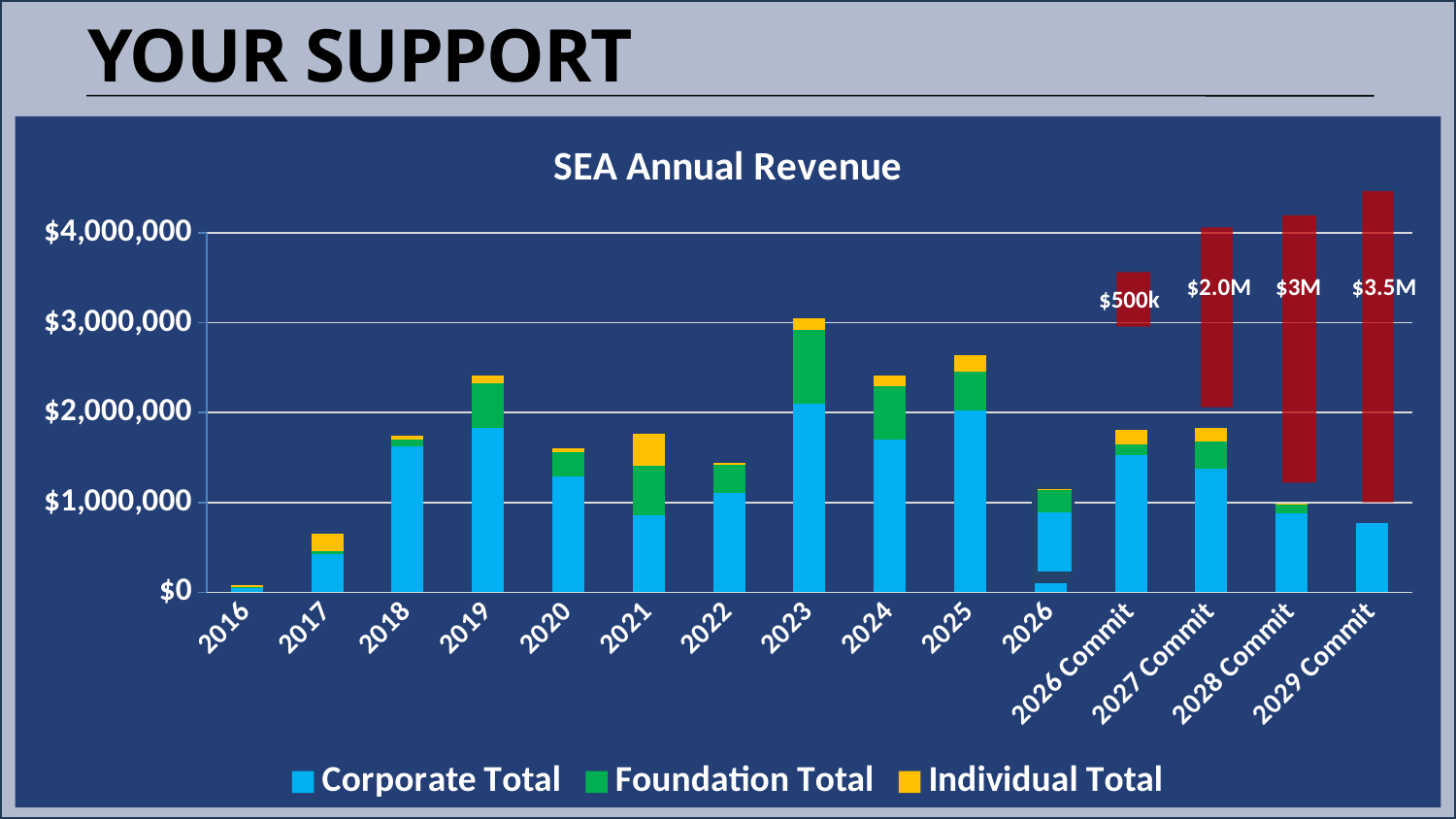
Which has the larger total stacked bar, 2024 or 2025? 2025 Is the total value for 2022 greater or less than $1,000,000? greater What type of chart is shown on the slide? bar chart Do the total values rise or fall from 2016 to 2019? rise What label is printed on the red bar above 2029 Commit? $3.5M Is the total value for 2019 greater or less than $2,000,000? greater Is the total value for 2017 greater or less than $1,000,000? less Which year has the highest total stacked bar? 2023 How many series does the legend list? 3 Which category has the lowest total stacked bar? 2016 What is the title of the chart? SEA Annual Revenue How many categories are shown along the x axis? 15